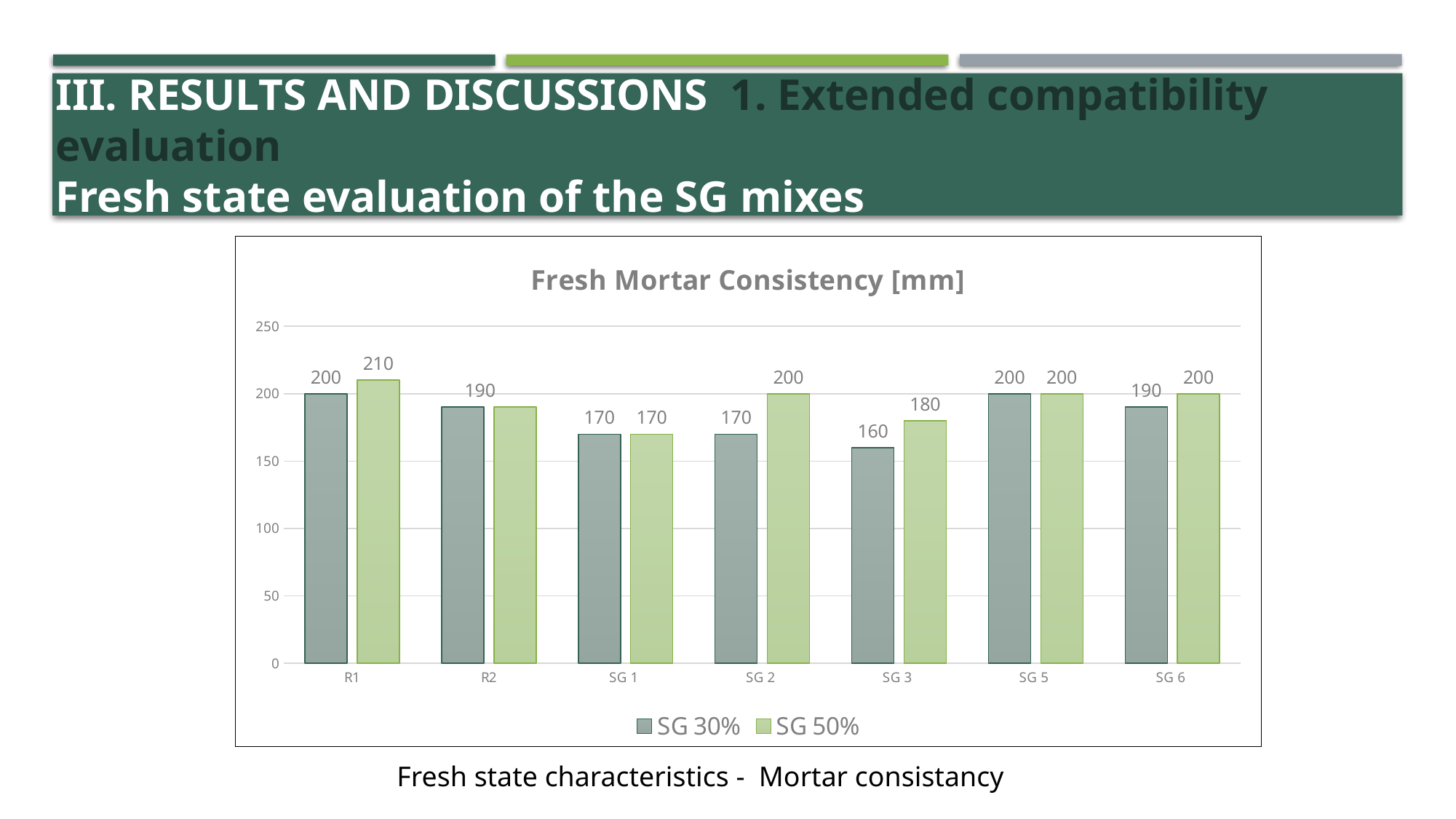
What is the SG 50% value for R1? 210 What kind of chart is shown on the slide? bar chart Which category has the lowest SG 30% value? SG 3 For SG 3, which series has the larger value, SG 30% or SG 50%? SG 50% What is the SG 50% value for SG 3? 180 What is the SG 30% value for SG 3? 160 Which category has the highest SG 50% value? R1 Is the SG 30% value for SG 1 greater or less than 200? less How many series does the legend list? 2 How many categories are shown on the x axis? 7 What is the SG 30% value for SG 6? 190 What is the difference between the SG 50% and SG 30% values for SG 2? 30